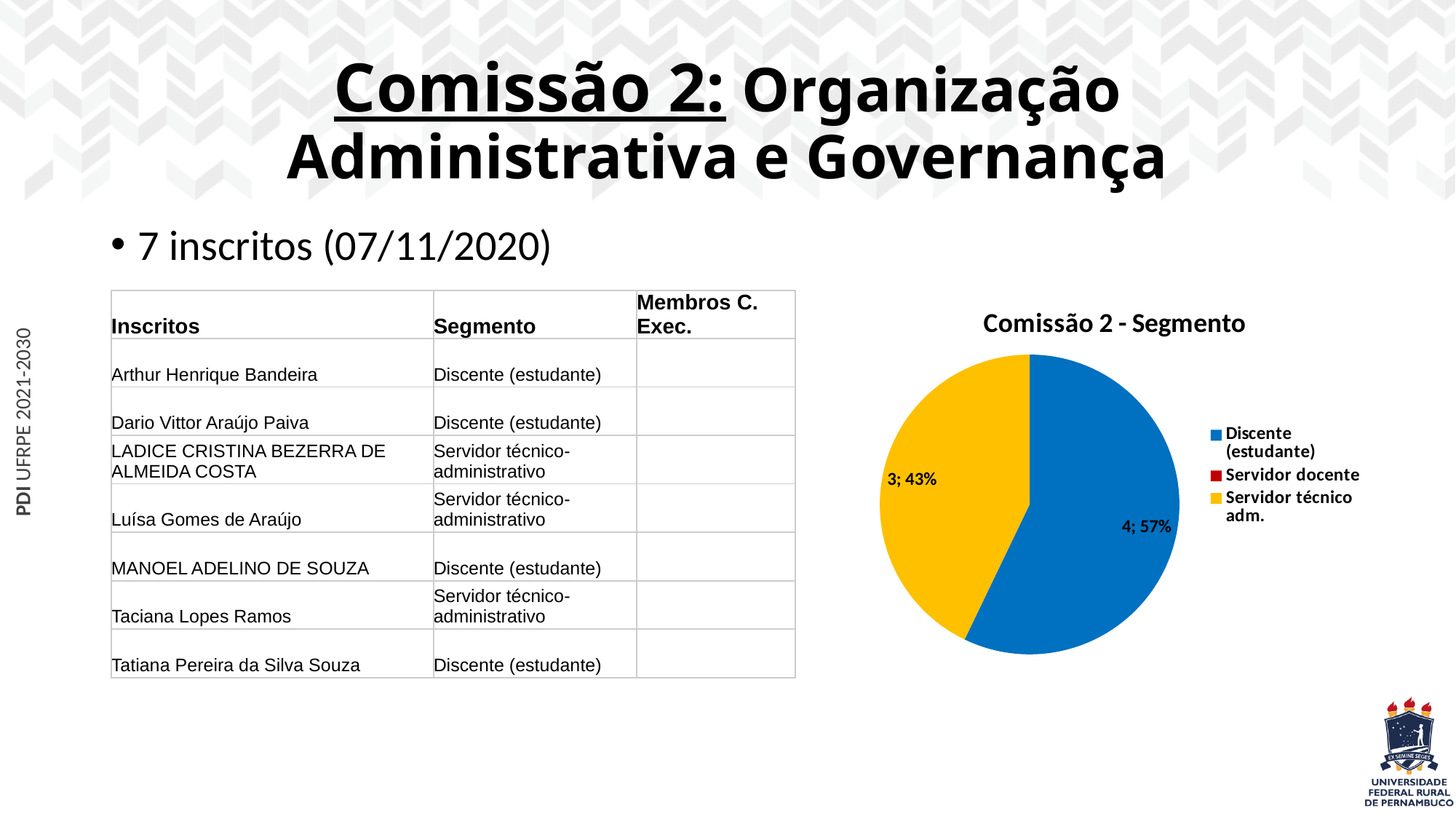
What is the count shown for Servidor técnico adm. in the pie chart? 3 Which of the two visible slices is smaller, Discente (estudante) or Servidor técnico adm.? Servidor técnico adm. How many slices are visible in the pie chart? 2 What share of the pie does Servidor técnico adm. represent? 43% What is the title of the chart on the slide? Comissão 2 - Segmento What colour is the Servidor técnico adm. slice in the pie chart? yellow Which segment has the largest slice in the pie chart? Discente (estudante) What kind of chart is shown on the slide? pie chart What is the difference in count between Discente (estudante) and Servidor técnico adm. in the pie chart? 1 How many entries does the legend of the pie chart list? 3 What is the count shown for Discente (estudante) in the pie chart? 4 What share of the pie does Discente (estudante) represent? 57%